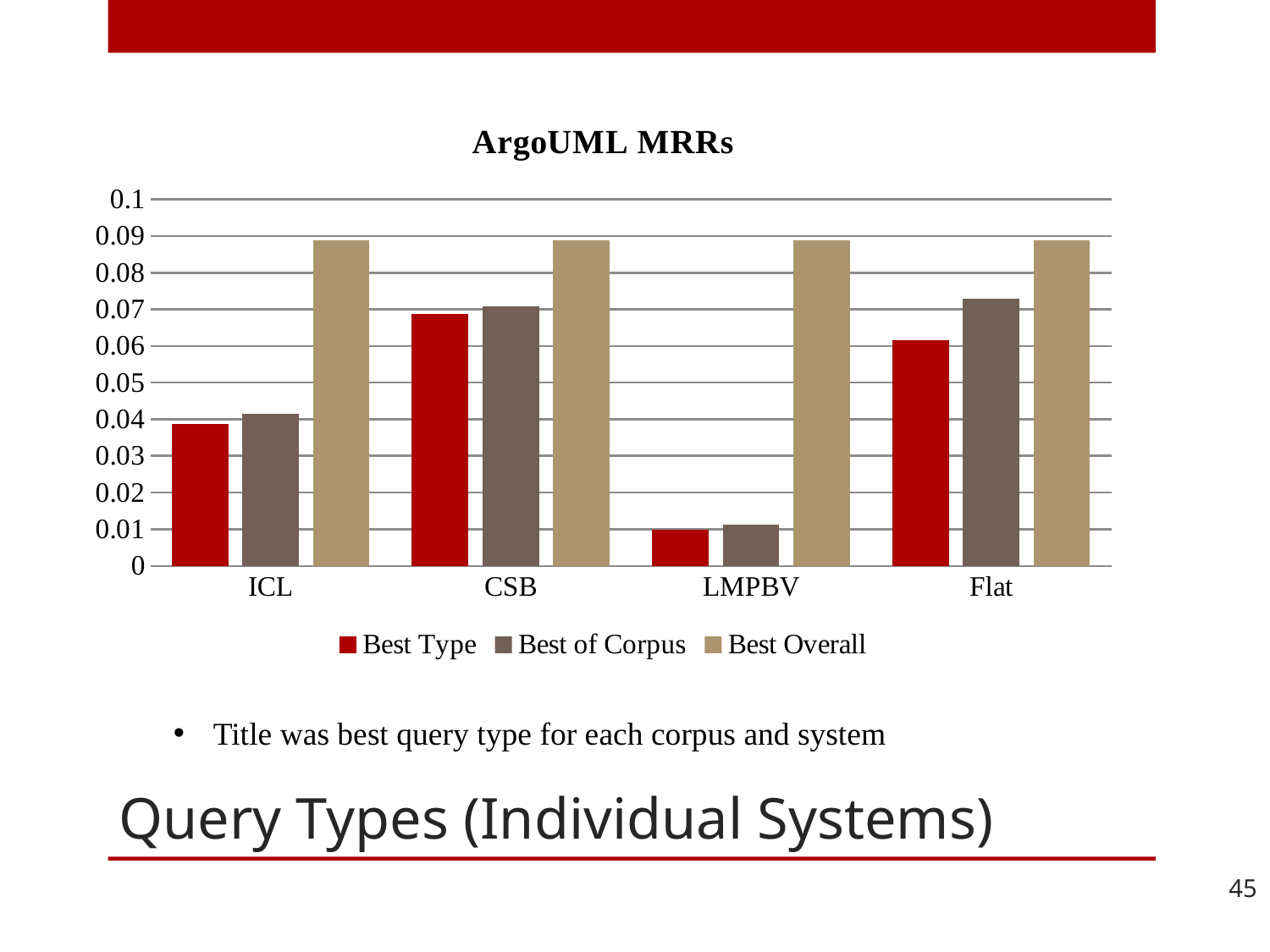
Which category has the highest Best Type value? CSB For Flat, which is larger: Best Type or Best of Corpus? Best of Corpus Which category has the lowest Best of Corpus value? LMPBV Which series is shown in red? Best Type Is the Best Type value for CSB greater or less than 0.06? greater How many series does the legend list? 3 What type of chart is shown on the slide? bar chart How many categories are shown on the x axis? 4 What is the title of the chart? ArgoUML MRRs Which category has the lowest Best Type value? LMPBV Is the Best Type value for LMPBV greater or less than 0.02? less Is the Best Overall value for ICL greater or less than 0.08? greater